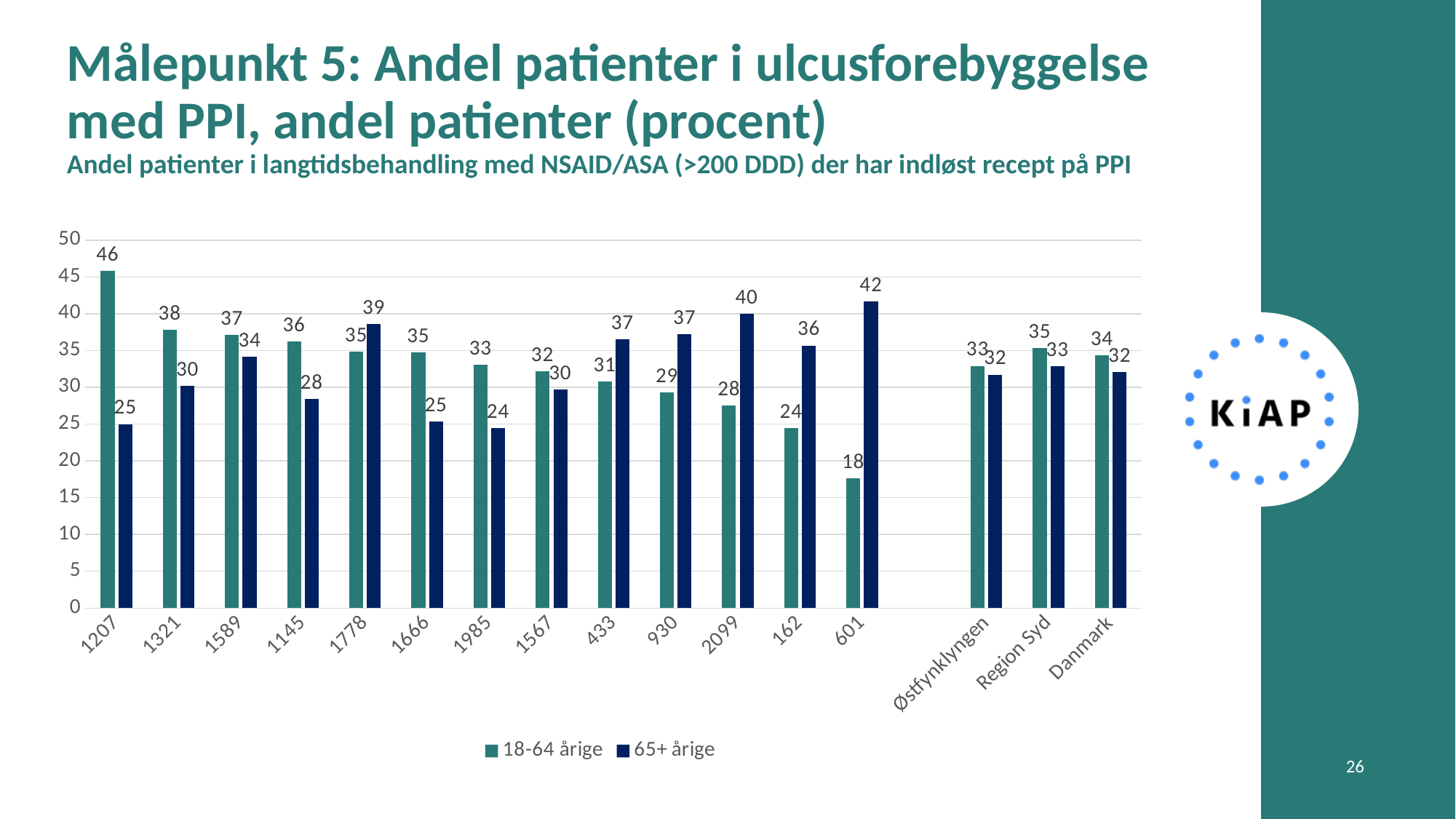
What kind of chart is shown on the slide? bar chart Which category has the highest value in the 65+ årige series? 601 Which category has the highest value in the 18-64 årige series? 1207 For category 2099, which series has the larger value, 18-64 årige or 65+ årige? 65+ årige Which category has the lowest value in the 18-64 årige series? 601 Is the 18-64 årige value for category 601 greater or less than 20? less What is the difference between the 18-64 årige and 65+ årige values for category 1207? 21 How many series does the legend list? 2 How many categories are shown on the x axis? 16 What is the value for the 18-64 årige series for category 1207? 46 What is the value for the 65+ årige series for category 601? 42 What is the value for the 65+ årige series for Danmark? 32